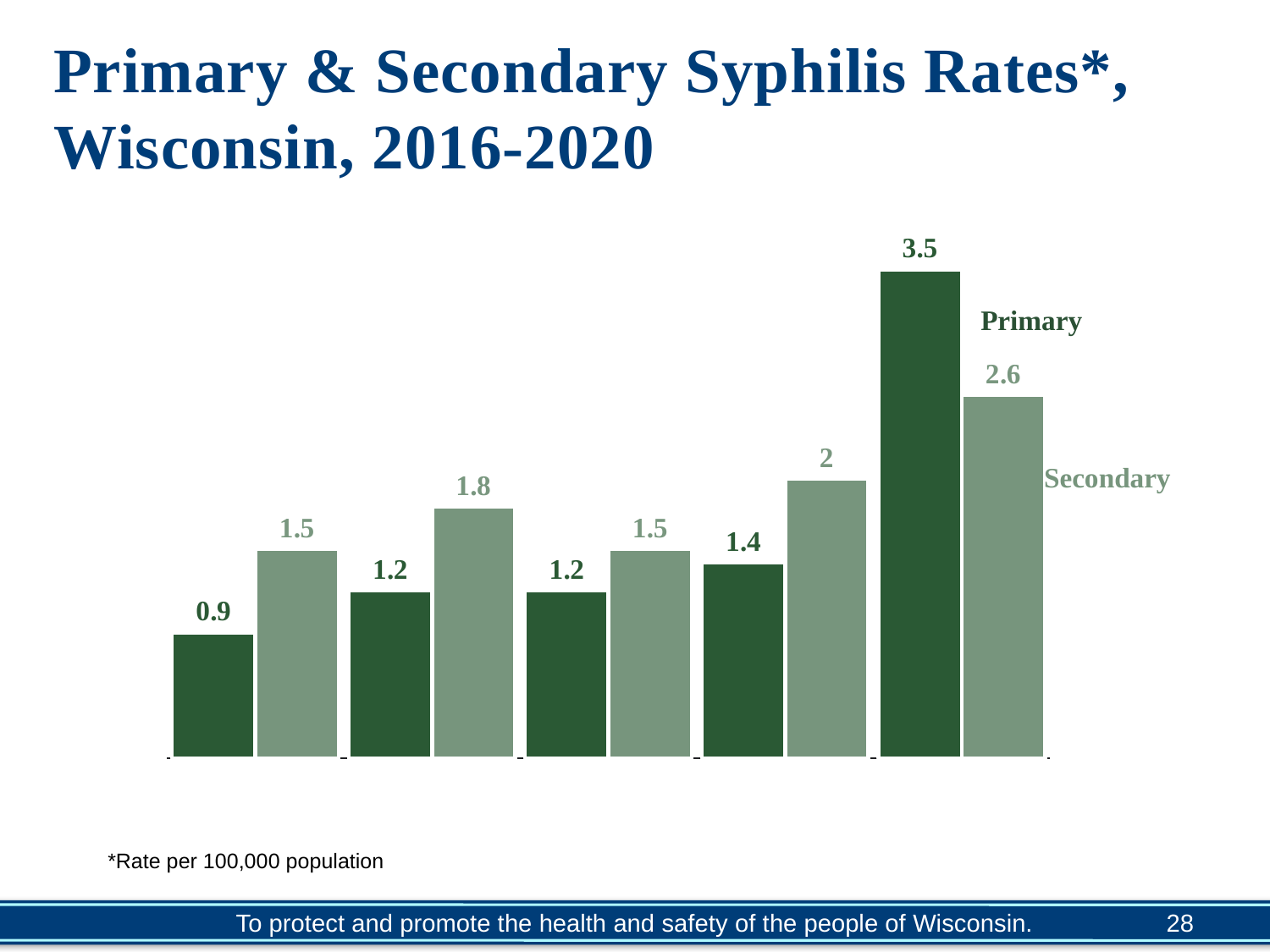
What is the Primary syphilis rate shown for the leftmost (first) group of bars? 0.9 In the leftmost group of bars, which is larger, the Primary rate or the Secondary rate? Secondary What is the Secondary syphilis rate shown for the rightmost (last) group of bars? 2.6 What type of chart is shown on the slide? Bar chart How many data series does the chart show? 2 In the rightmost group of bars, which is larger, the Primary rate or the Secondary rate? Primary What is the Secondary rate shown for the fourth group of bars from the left? 2 What is the difference between the Primary and Secondary rates in the rightmost group of bars? 0.9 According to the footnote, what unit are the rates expressed in? Rate per 100,000 population How many groups of bars (years) are shown on the chart? 5 What is the lowest Secondary rate shown on the chart? 1.5 What is the highest Primary rate shown on the chart? 3.5